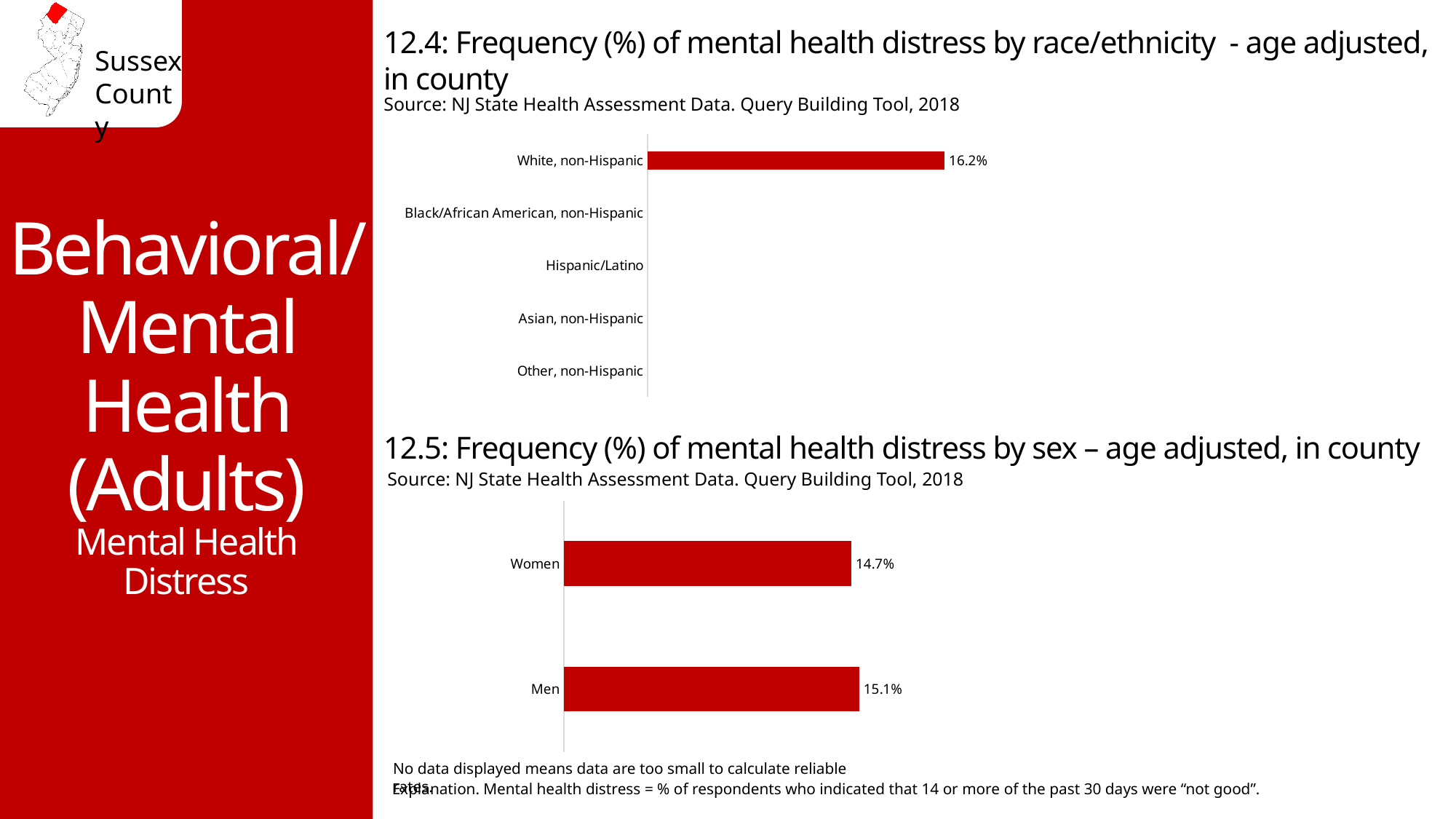
In chart 12.5 (mental health distress by sex), what is the difference between the values for Men and Women? 0.4% In chart 12.4 (mental health distress by race/ethnicity), which category is the only one with a bar displayed? White, non-Hispanic What kind of chart is chart 12.5 (mental health distress by sex)? Bar chart What kind of chart is chart 12.4 (mental health distress by race/ethnicity)? Bar chart In chart 12.4 (mental health distress by race/ethnicity), how many race/ethnicity categories are listed on the axis? 5 In chart 12.5 (mental health distress by sex), how many categories are shown? 2 In chart 12.5 (mental health distress by sex), what is the value for Women? 14.7% In chart 12.5 (mental health distress by sex), which category has the lower value? Women In chart 12.4 (mental health distress by race/ethnicity), what is the value for White, non-Hispanic? 16.2% In chart 12.5 (mental health distress by sex), which category has the higher value? Men Which is larger: the value for White, non-Hispanic in chart 12.4 or the value for Men in chart 12.5? White, non-Hispanic in chart 12.4 In chart 12.5 (mental health distress by sex), what is the value for Men? 15.1%